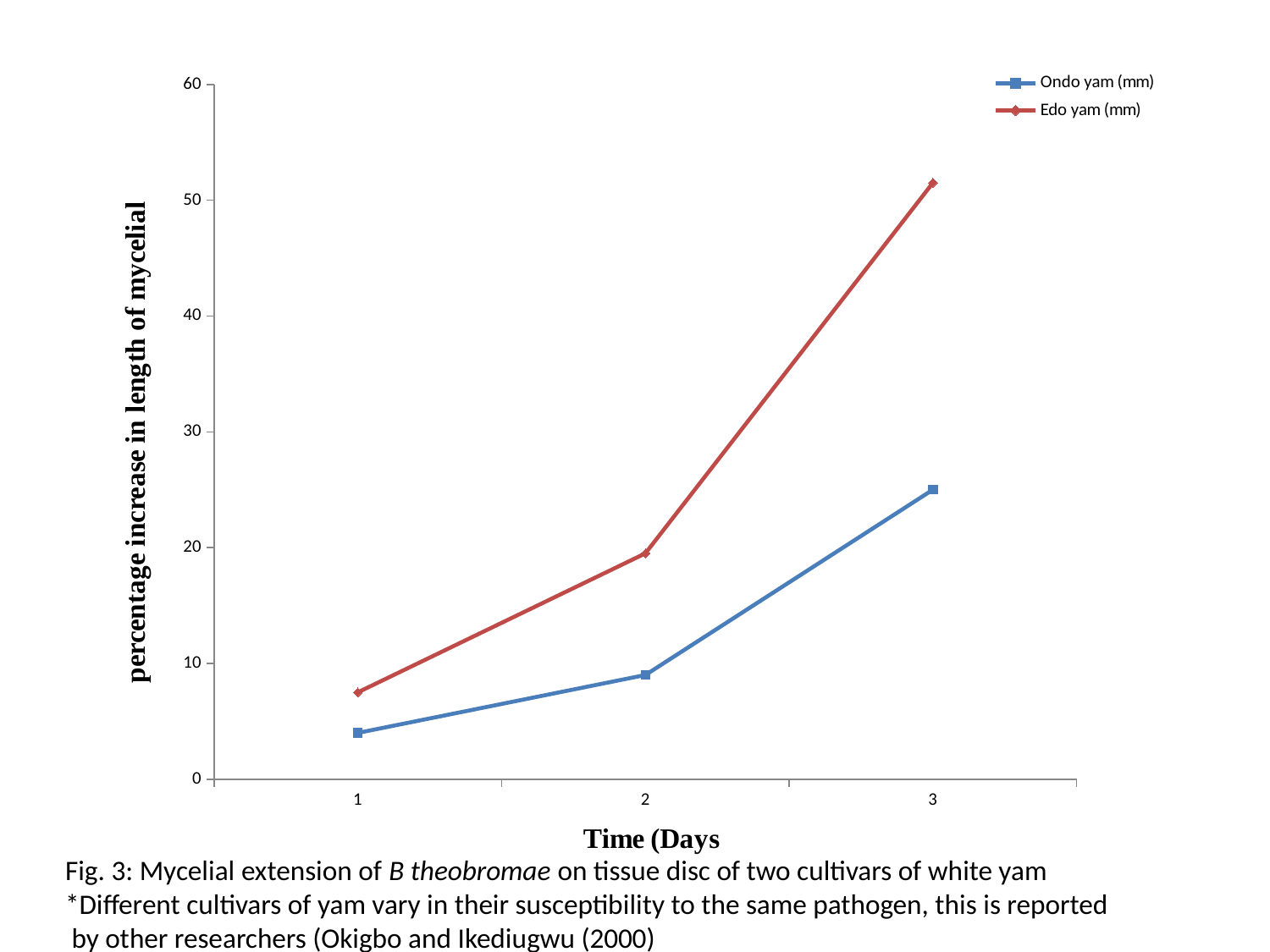
What is the title of the y axis? percentage increase in length of mycelial At which day is the value for Ondo yam (mm) lowest? 1 How many series does the legend list? 2 Is the value for Ondo yam (mm) at day 3 greater or less than 20? greater What kind of chart is shown on the slide? line chart Do the values for Ondo yam (mm) rise or fall from day 1 to day 3? rise How many time points are plotted along the x axis? 3 At day 3, which series has the larger value, Ondo yam (mm) or Edo yam (mm)? Edo yam (mm) Is the value for Ondo yam (mm) at day 1 greater or less than 10? less At which day is the value for Edo yam (mm) highest? 3 Do the values for Edo yam (mm) rise or fall as time in days increases? rise Is the value for Edo yam (mm) at day 3 greater or less than 40? greater